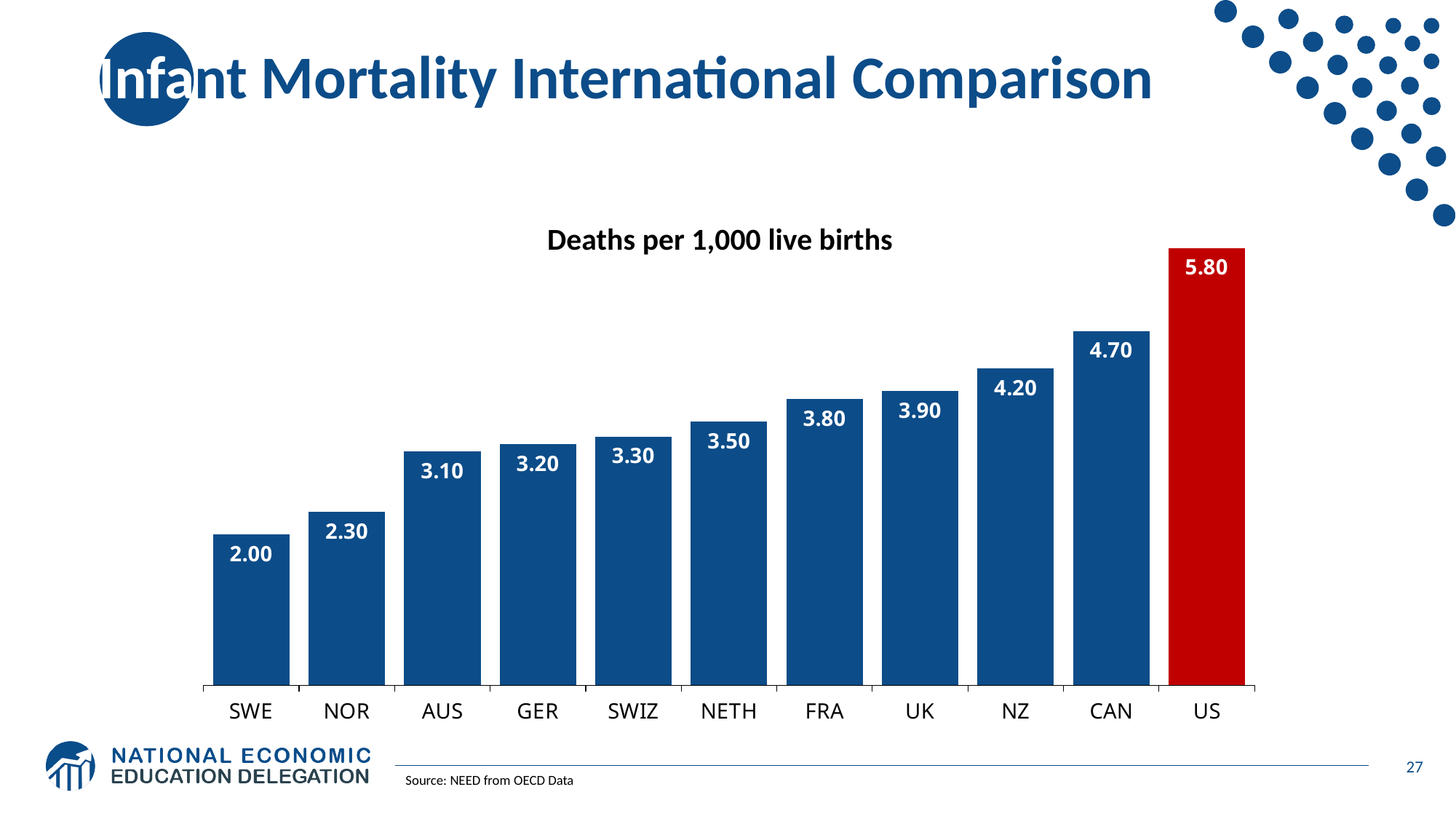
Which country has the highest value? US What is the difference between the values for NZ and SWE? 2.20 What is the value for the US? 5.80 How many countries are shown on the chart? 11 What kind of chart is this? Bar chart Which country has the lowest value? SWE What is the title of the chart? Deaths per 1,000 live births What is the value for NETH? 3.50 What is the difference between the values for the US and CAN? 1.10 What is the value for GER? 3.20 Which has a larger value, FRA or UK? UK Do the values rise or fall from left to right along the x axis? Rise